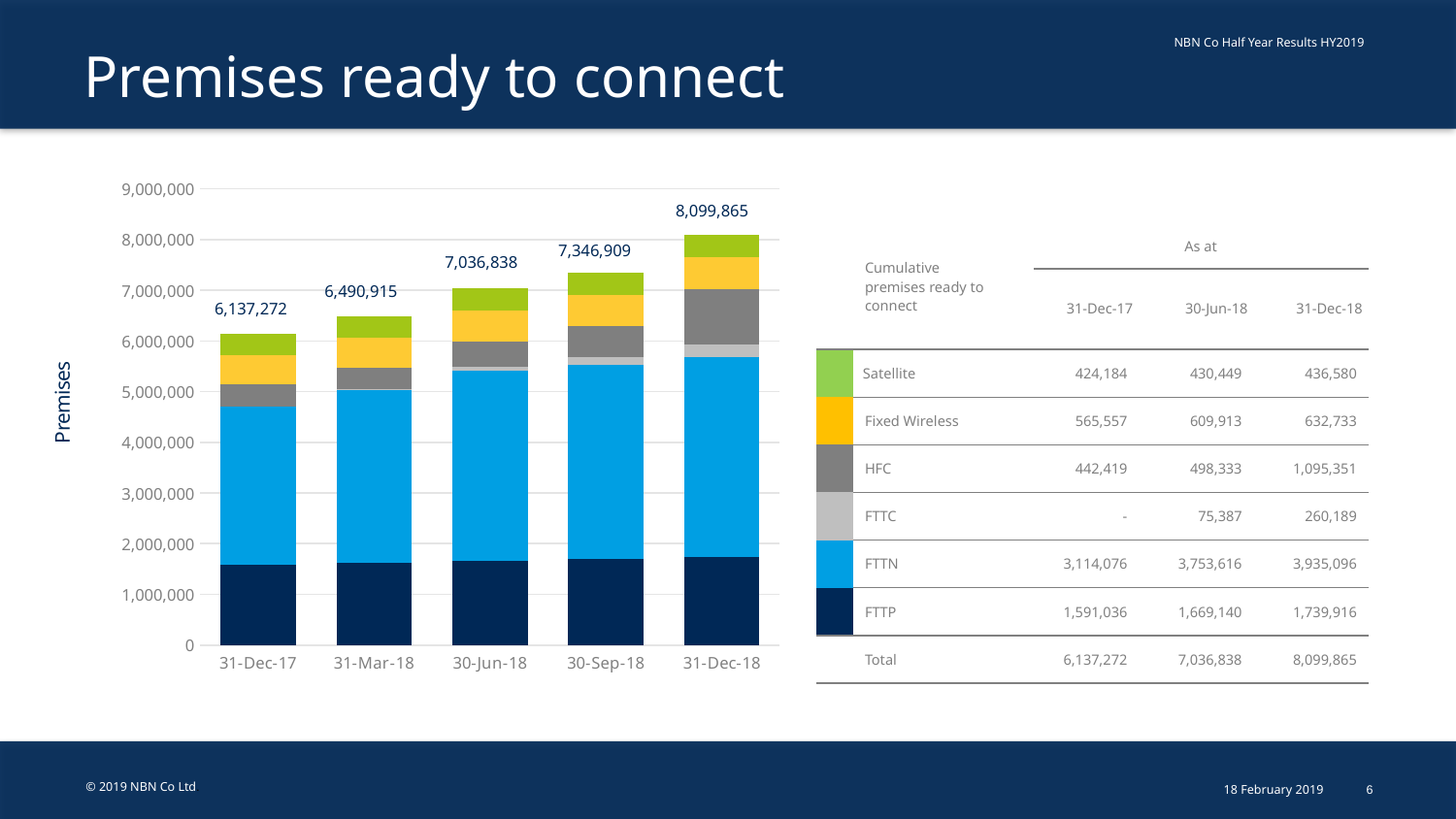
How many dates (bars) are shown on the chart? 5 Do the total premises ready to connect rise or fall from 31-Dec-17 to 31-Dec-18? Rise What is the difference between the total for 31-Dec-18 and the total for 31-Dec-17? 1,962,593 What kind of chart is shown on the slide? Stacked bar chart What is the total value labelled on the bar for 31-Mar-18? 6,490,915 What is the total number of premises ready to connect shown for 31-Dec-18? 8,099,865 Which is larger, the total for 30-Jun-18 or the total for 31-Mar-18? 30-Jun-18 Which date has the lowest total of premises ready to connect? 31-Dec-17 What is the total value labelled on the bar for 30-Sep-18? 7,346,909 Is the FTTP (dark blue) segment for 31-Mar-18 greater or less than 2,000,000? less What is the difference between the totals for 30-Sep-18 and 30-Jun-18? 310,071 Which date has the highest total of premises ready to connect? 31-Dec-18